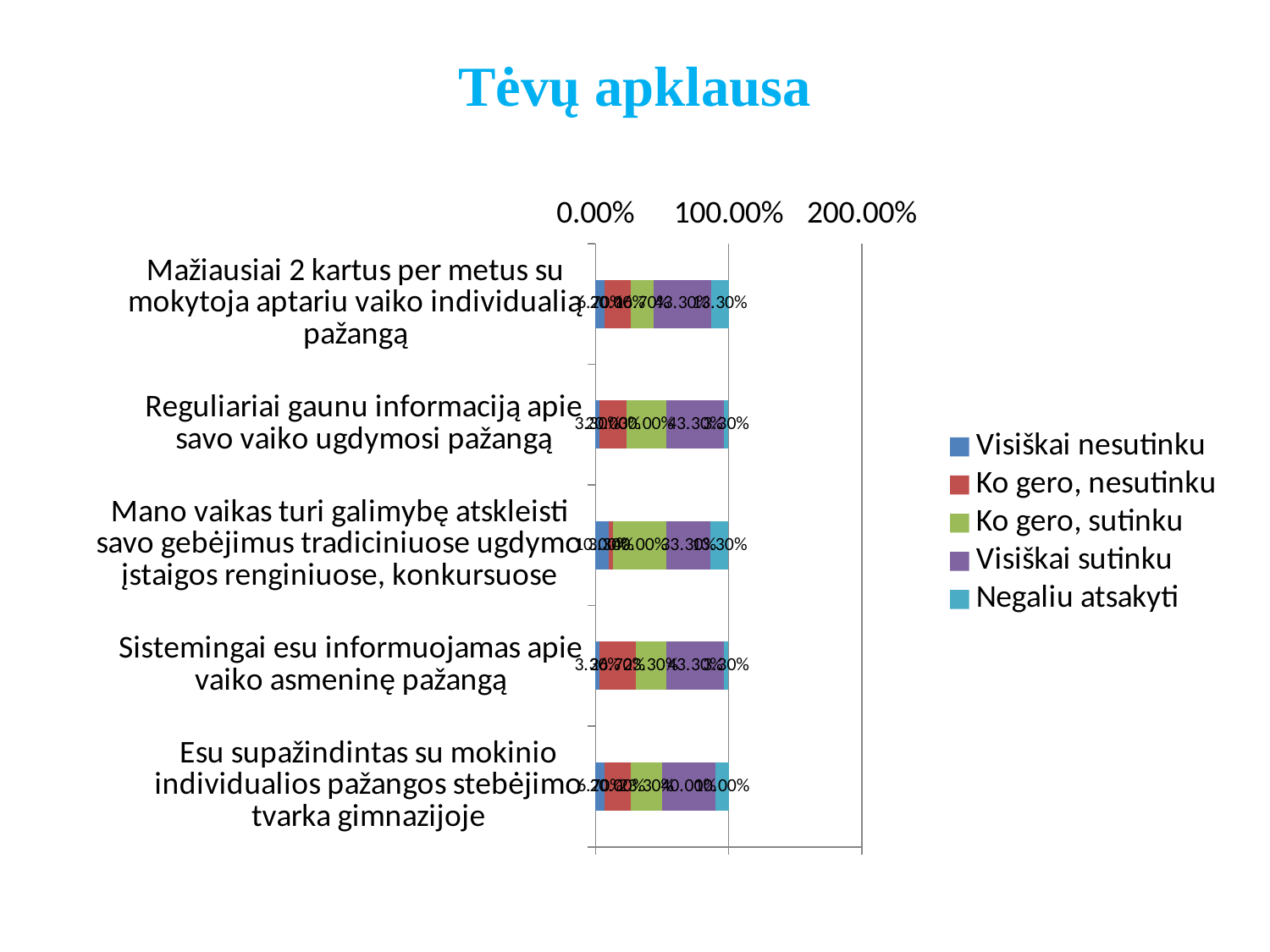
Is the total of the bar for 'Esu supažindintas su mokinio individualios pažangos stebėjimo tvarka gimnazijoje' greater or less than 200.00%? less Is the total of the bar for 'Reguliariai gaunu informaciją apie savo vaiko ugdymosi pažangą' greater or less than 200.00%? less Which series is listed first in the legend? Visiškai nesutinku Which is larger: the 'Visiškai sutinku' segment for 'Mažiausiai 2 kartus per metus su mokytoja aptariu vaiko individualią pažangą' or for 'Mano vaikas turi galimybę atskleisti savo gebėjimus tradiciniuose ugdymo įstaigos renginiuose, konkursuose'? Mažiausiai 2 kartus per metus su mokytoja aptariu vaiko individualią pažangą What kind of chart is shown on the slide? stacked bar chart How many categories (statements) are plotted on the chart? 5 What is the title of the slide containing the chart? Tėvų apklausa How many series does the legend list? 5 What is the highest value shown on the horizontal axis of the chart? 200.00%